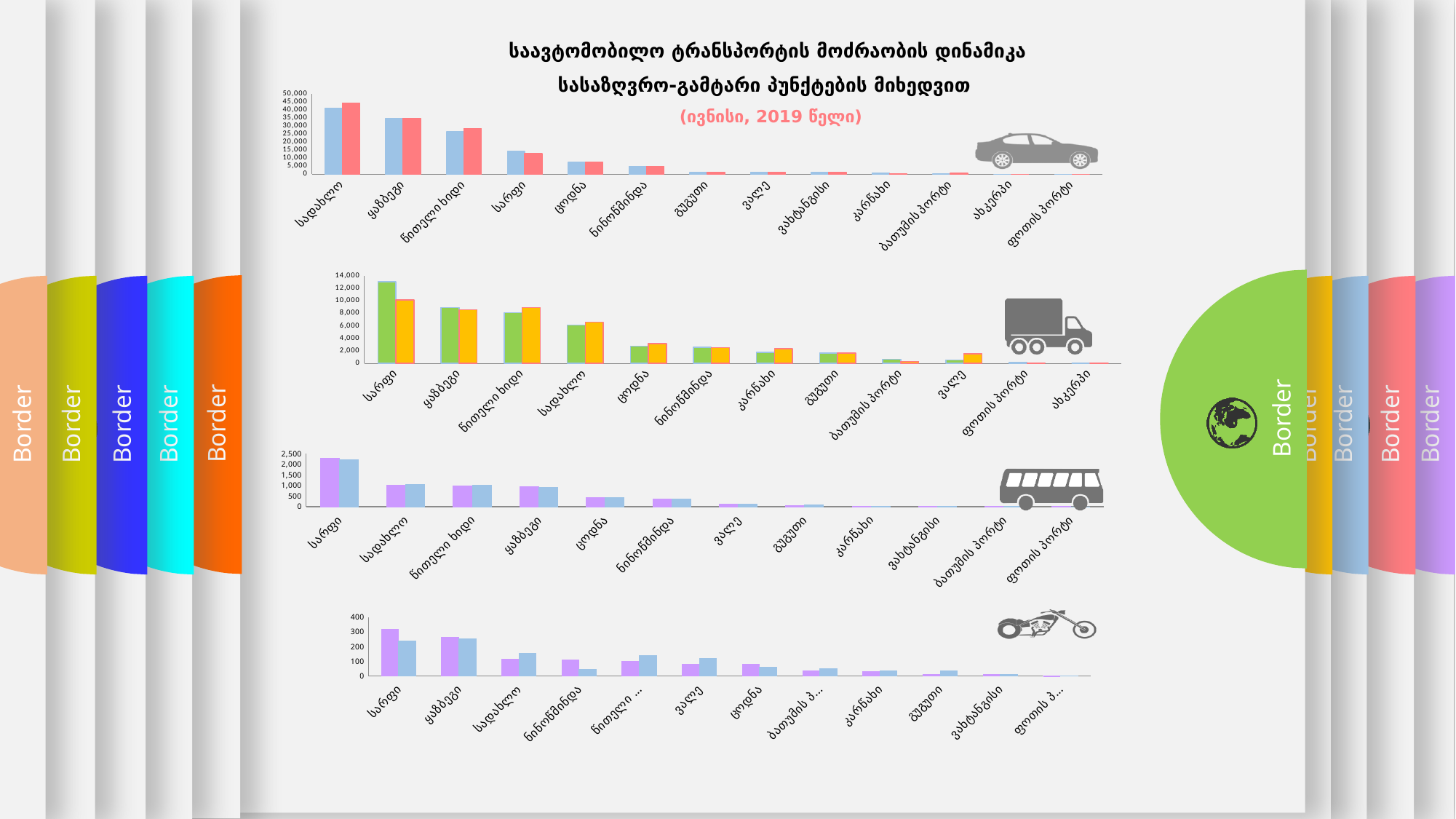
In the top chart (with the car icon), are the values for სადახლო greater or less than 35,000? greater In the second chart from the top (with the truck icon), are the values for ცოდნა greater or less than 4,000? less In the second chart from the top (with the truck icon), which category has the highest values? სარფი In the bottom chart (with the motorcycle icon), which category has the highest value? სარფი How many categories are shown on the x axis of the top chart (with the car icon)? 13 What year is given in the subtitle of the slide's charts? 2019 In the top chart (with the car icon), are the values for სარფი greater or less than 20,000? less In the top chart (with the car icon), do the values generally rise or fall from left to right along the x axis? fall What kind of chart is the top chart on the slide (with the car icon)? bar chart How many categories are shown on the x axis of the second chart from the top (with the truck icon)? 12 In the top chart (with the car icon), which category has the highest values? სადახლო